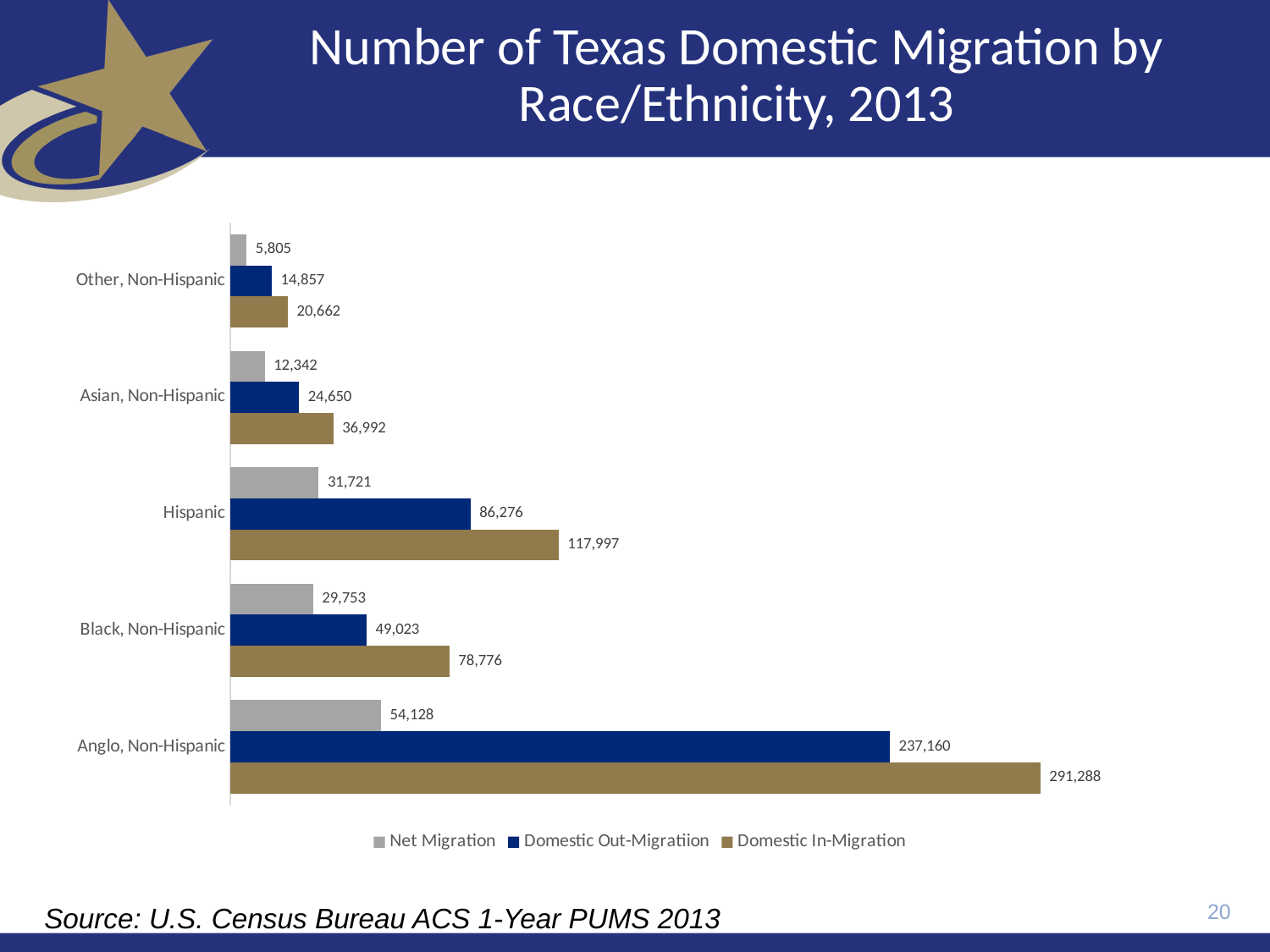
Which race/ethnicity category has the lowest Net Migration? Other, Non-Hispanic What is the difference between Domestic In-Migration and Domestic Out-Migration for Anglo, Non-Hispanic? 54,128 What kind of chart is shown on the slide? Bar chart What is the Domestic In-Migration value for Hispanic? 117,997 What is the title of the chart? Number of Texas Domestic Migration by Race/Ethnicity, 2013 What is the Domestic Out-Migration value for Asian, Non-Hispanic? 24,650 How many race/ethnicity categories are shown on the chart? 5 What is the Net Migration value for Anglo, Non-Hispanic? 54,128 Which is larger, the Domestic Out-Migration for Hispanic or for Black, Non-Hispanic? Hispanic What is the difference between Domestic In-Migration and Domestic Out-Migration for Black, Non-Hispanic? 29,753 How many series does the legend list? 3 Which race/ethnicity category has the highest Domestic In-Migration? Anglo, Non-Hispanic